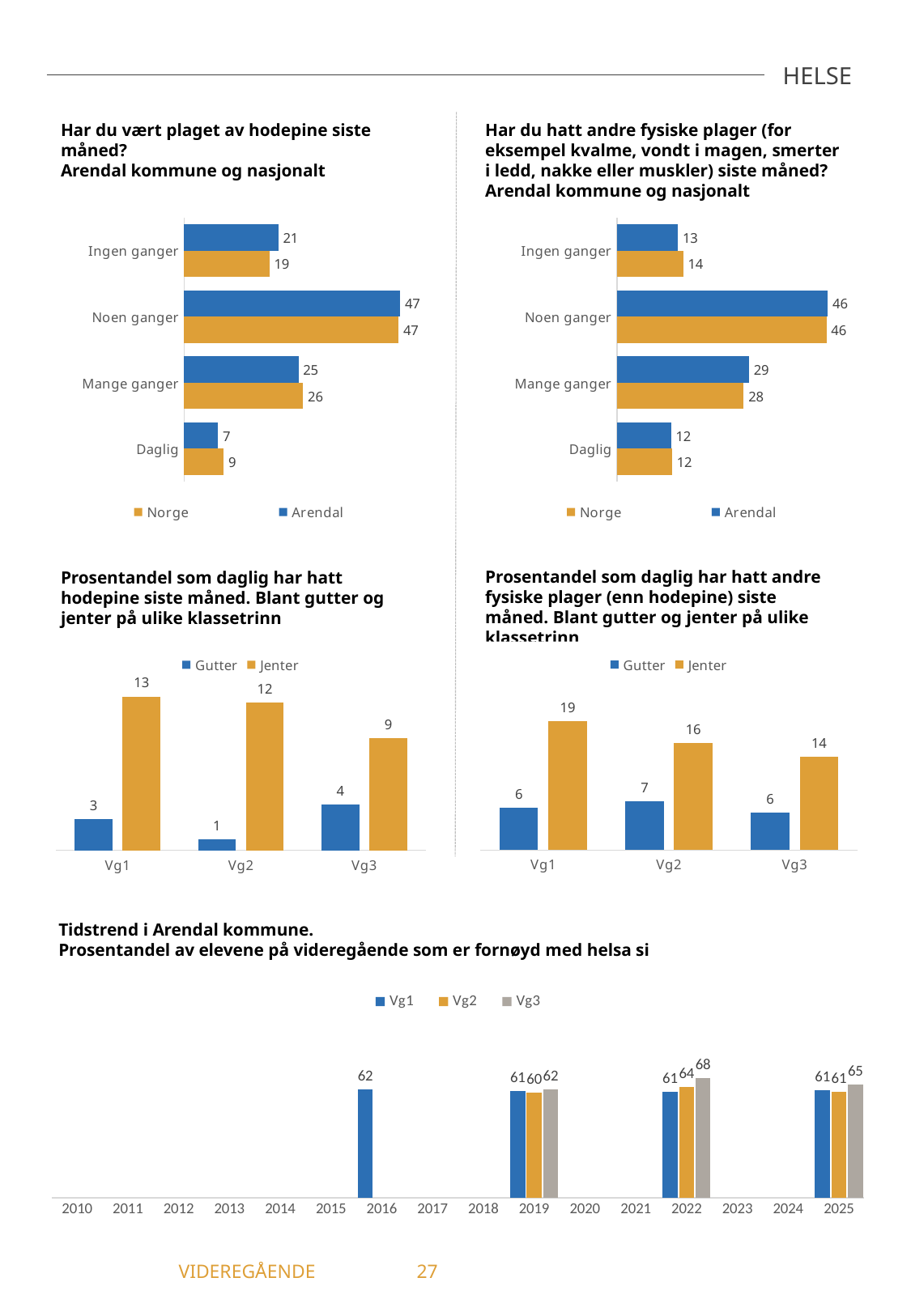
In the middle-right chart 'Prosentandel som daglig har hatt andre fysiske plager', do the Jenter values rise or fall from Vg1 to Vg3? fall In the bottom chart 'Tidstrend i Arendal kommune', what is the value for Vg3 in 2022? 68 In the top-right chart 'Har du hatt andre fysiske plager...', how many series does the legend list? 2 In the top-right chart 'Har du hatt andre fysiske plager...', what is the value for Norge in the 'Mange ganger' category? 28 In the top-left chart 'Har du vært plaget av hodepine siste måned?', what is the value for Arendal in the 'Noen ganger' category? 47 In the top-left chart 'Har du vært plaget av hodepine siste måned?', what is the difference between the Norge and Arendal values for 'Daglig'? 2 In the middle-right chart 'Prosentandel som daglig har hatt andre fysiske plager', what is the difference between Jenter and Gutter at Vg1? 13 In the bottom chart 'Tidstrend i Arendal kommune', which is larger in 2019: Vg2 or Vg3? Vg3 What kind of chart is the bottom chart 'Tidstrend i Arendal kommune'? bar chart In the middle-left chart 'Prosentandel som daglig har hatt hodepine siste måned', which class level has the lowest value for Gutter? Vg2 In the top-right chart 'Har du hatt andre fysiske plager...', which category has the highest value for Arendal? Noen ganger In the middle-left chart 'Prosentandel som daglig har hatt hodepine siste måned', what is the value for Jenter at Vg2? 12